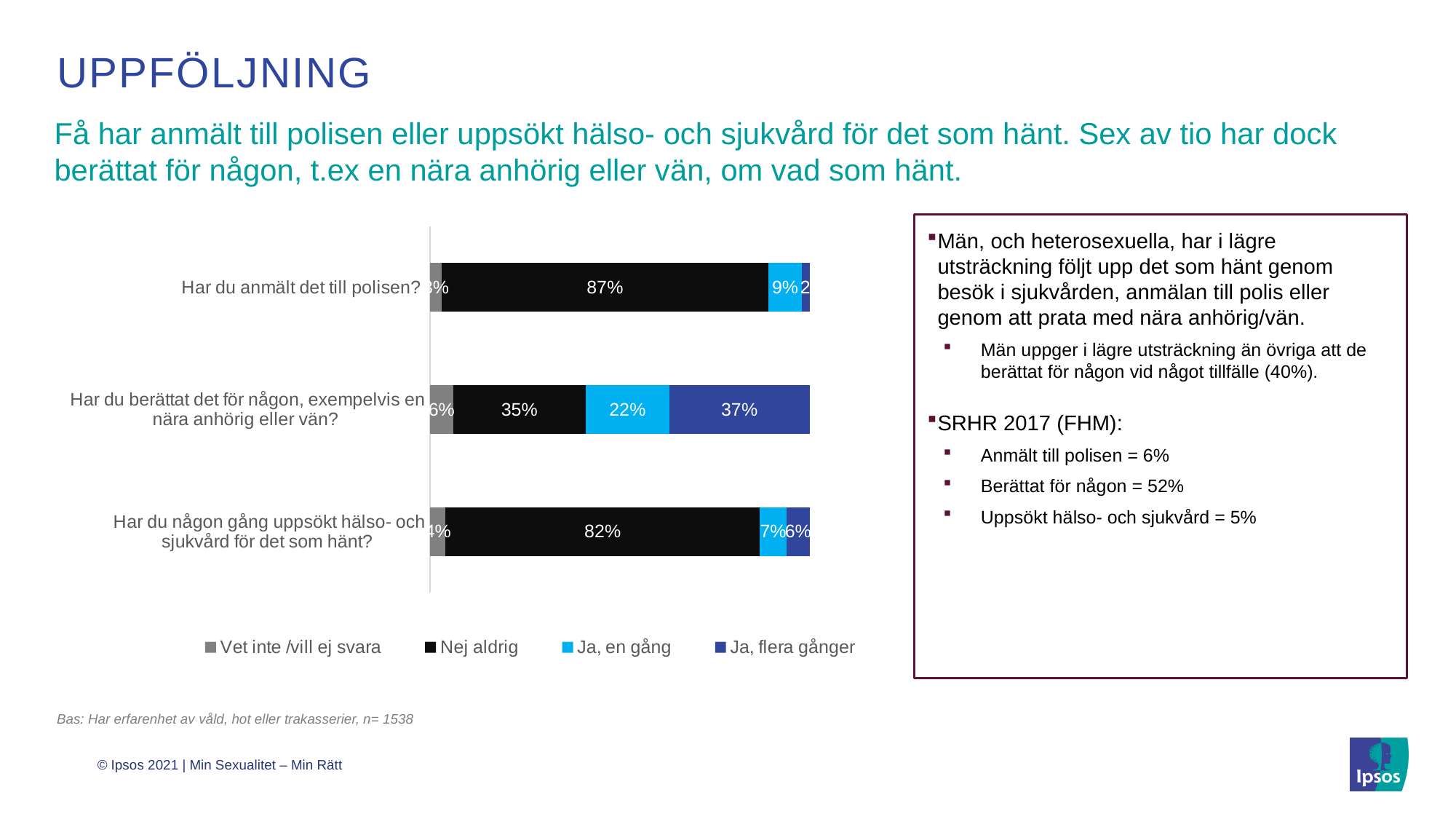
Which legend entry is shown in black? Nej aldrig What percentage answered "Nej aldrig" to "Har du anmält det till polisen?"? 87% What percentage answered "Nej aldrig" to "Har du någon gång uppsökt hälso- och sjukvård för det som hänt?"? 82% What percentage answered "Ja, en gång" to "Har du berättat det för någon, exempelvis en nära anhörig eller vän?"? 22% What percentage answered "Ja, flera gånger" to "Har du berättat det för någon, exempelvis en nära anhörig eller vän?"? 37% Which question has the highest share of "Nej aldrig" answers? Har du anmält det till polisen? What is the difference in "Nej aldrig" share between "Har du anmält det till polisen?" and "Har du någon gång uppsökt hälso- och sjukvård för det som hänt?"? 5 percentage points What percentage answered "Ja, en gång" to "Har du anmält det till polisen?"? 9% Which question has the larger "Ja, en gång" share: "Har du berättat det för någon..." or "Har du någon gång uppsökt hälso- och sjukvård..."? Har du berättat det för någon, exempelvis en nära anhörig eller vän? How many answer options does the legend list? 4 What type of chart is shown on the slide? Stacked bar chart How many questions (categories) are shown in the chart? 3